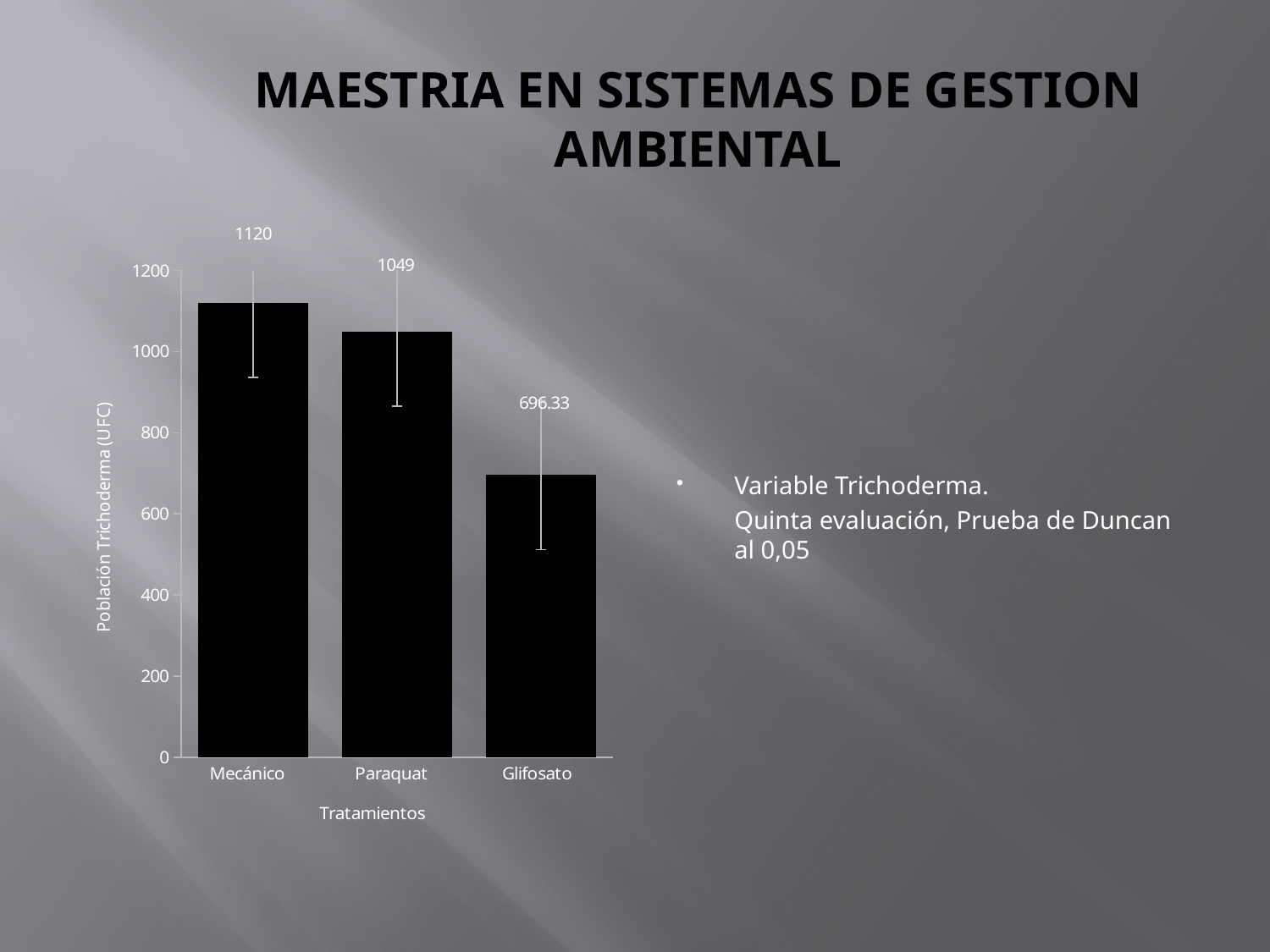
Which treatment has the lowest Trichoderma population? Glifosato What is the value for Glifosato? 696.33 What is the value for Paraquat? 1049 What is the value for Mecánico? 1120 Is the value for Glifosato greater or less than 800? less What kind of chart is shown on the slide? bar chart What is the label of the y axis? Población Trichoderma (UFC) Which is larger, the value for Paraquat or the value for Glifosato? Paraquat How many treatments are shown on the x axis? 3 Which treatment has the highest Trichoderma population? Mecánico What is the difference between the values for Paraquat and Glifosato? 352.67 What is the difference between the values for Mecánico and Paraquat? 71